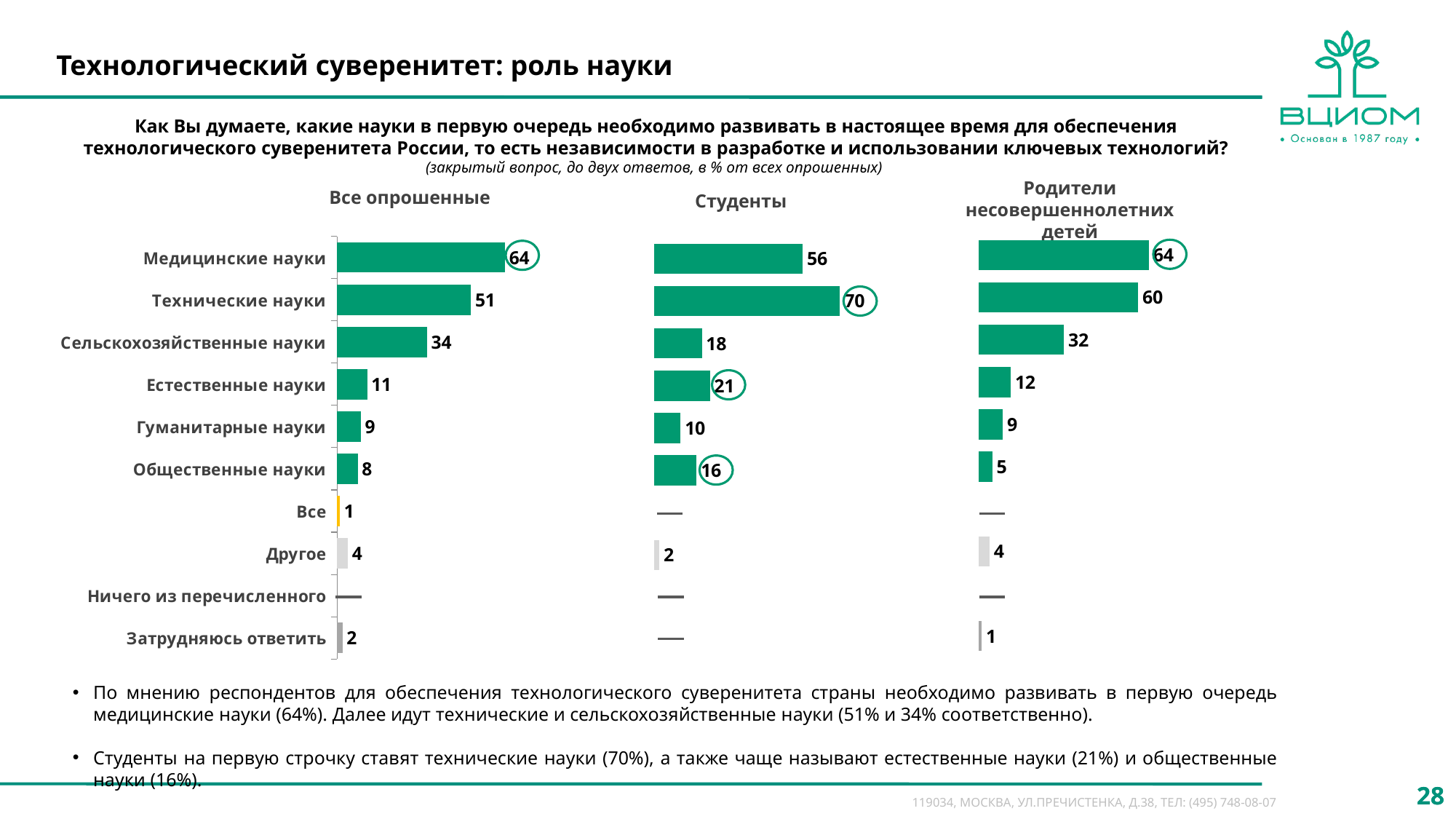
In the 'Студенты' chart, what is the value for 'Общественные науки'? 16 In the 'Родители несовершеннолетних детей' chart, what is the value for 'Сельскохозяйственные науки'? 32 In the 'Студенты' chart, what is the value for 'Технические науки'? 70 In the 'Студенты' chart, which category has the highest value? Технические науки In the 'Студенты' chart, what is the difference between 'Технические науки' and 'Медицинские науки'? 14 In the 'Все опрошенные' chart, what is the value for 'Медицинские науки'? 64 In the 'Все опрошенные' chart, which category has the highest value? Медицинские науки In the 'Студенты' chart, which is larger: 'Естественные науки' or 'Сельскохозяйственные науки'? Естественные науки In the 'Все опрошенные' chart, what is the difference between 'Медицинские науки' and 'Технические науки'? 13 What kind of chart is used on this slide? Bar chart How many charts are shown on the slide? 3 In the 'Родители несовершеннолетних детей' chart, which is larger: 'Медицинские науки' or 'Технические науки'? Медицинские науки